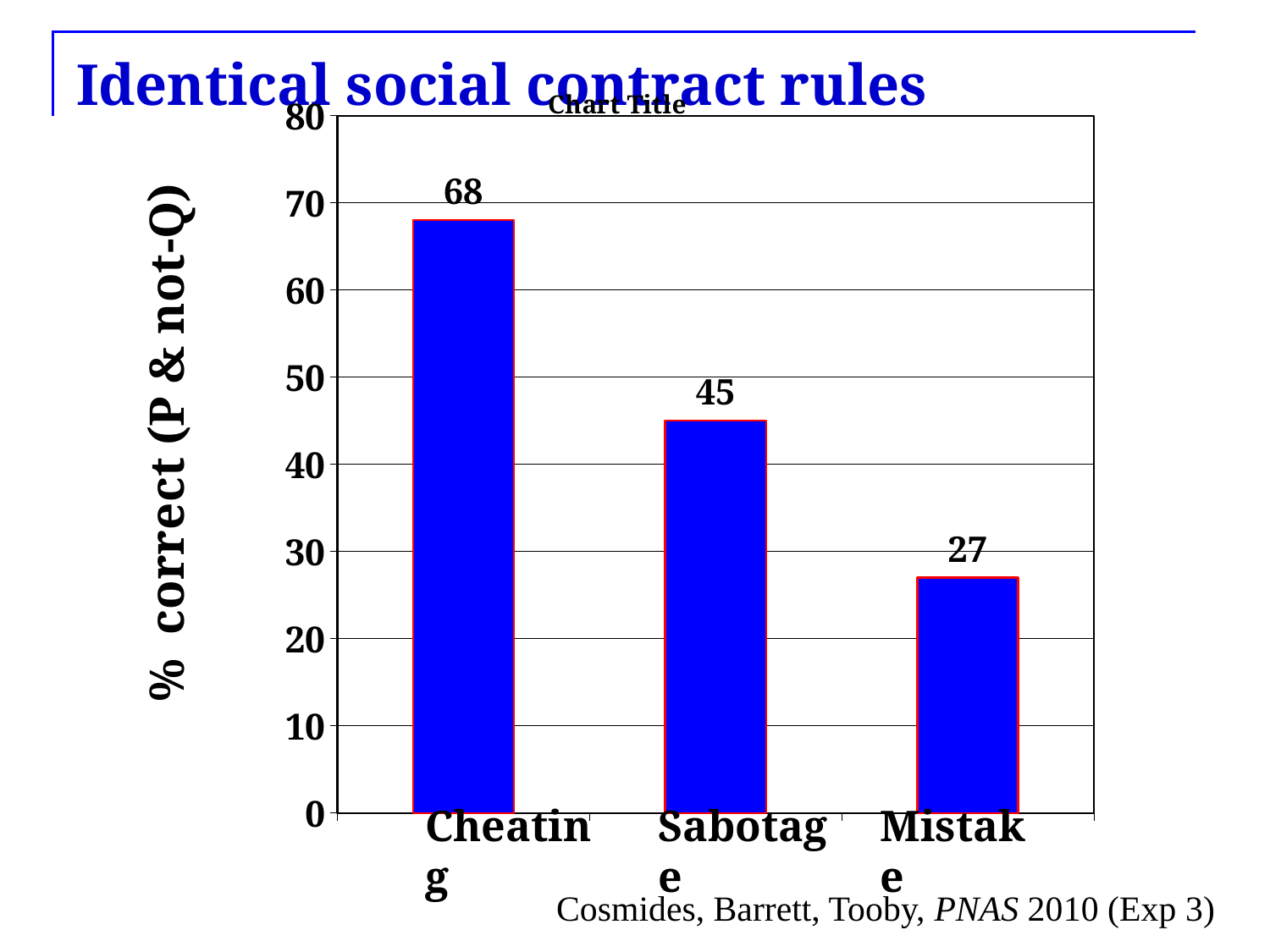
What is the value for Mistake? 27 What is the difference between the values for Sabotage and Mistake? 18 What is the value for Sabotage? 45 What is the difference between the values for Cheating and Sabotage? 23 Which category has the highest value? Cheating Which category has the lowest value? Mistake What kind of chart is shown on the slide? bar chart Do the values rise or fall from left to right across the categories? fall What is the label of the vertical axis? % correct (P & not-Q) How many categories are shown on the chart? 3 What is the value for Cheating? 68 Which is larger, the value for Sabotage or the value for Mistake? Sabotage